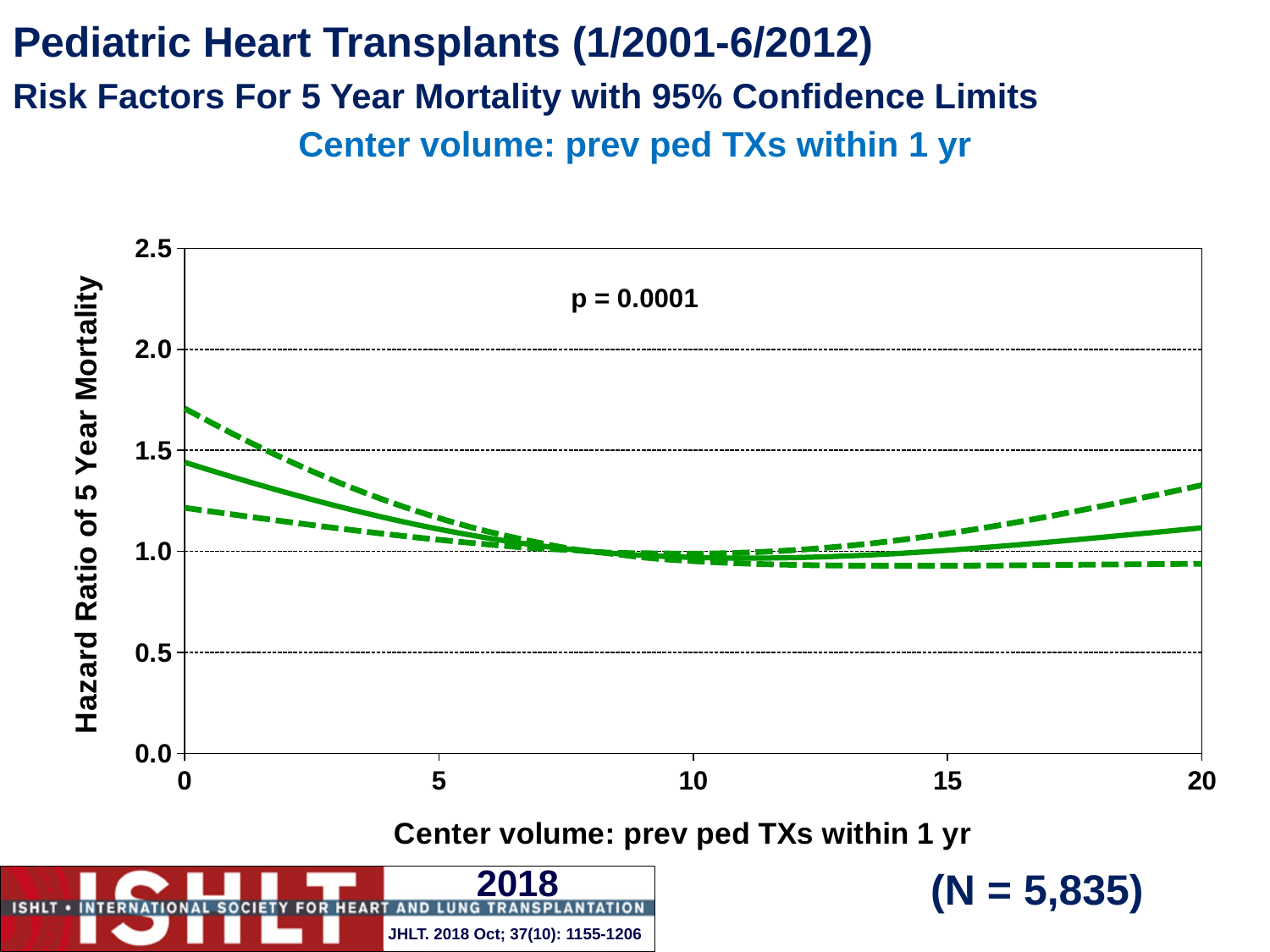
Is the upper 95% confidence limit (upper dashed line) at a center volume of 0 greater or less than 1.5? greater What kind of chart is shown on the slide? line chart Is the lower 95% confidence limit (lower dashed line) at a center volume of 20 greater or less than 1.0? less What p-value is printed on the chart? p = 0.0001 What is the highest value shown on the y-axis of the chart? 2.5 Is the hazard ratio (solid line) at a center volume of 0 greater or less than 1.0? greater What sample size (N) is shown on the slide? N = 5,835 Does the hazard ratio (solid line) rise or fall as center volume increases from 10 to 20? rise Does the hazard ratio (solid line) rise or fall as center volume increases from 0 to 10? fall How many lines are plotted on the chart? 3